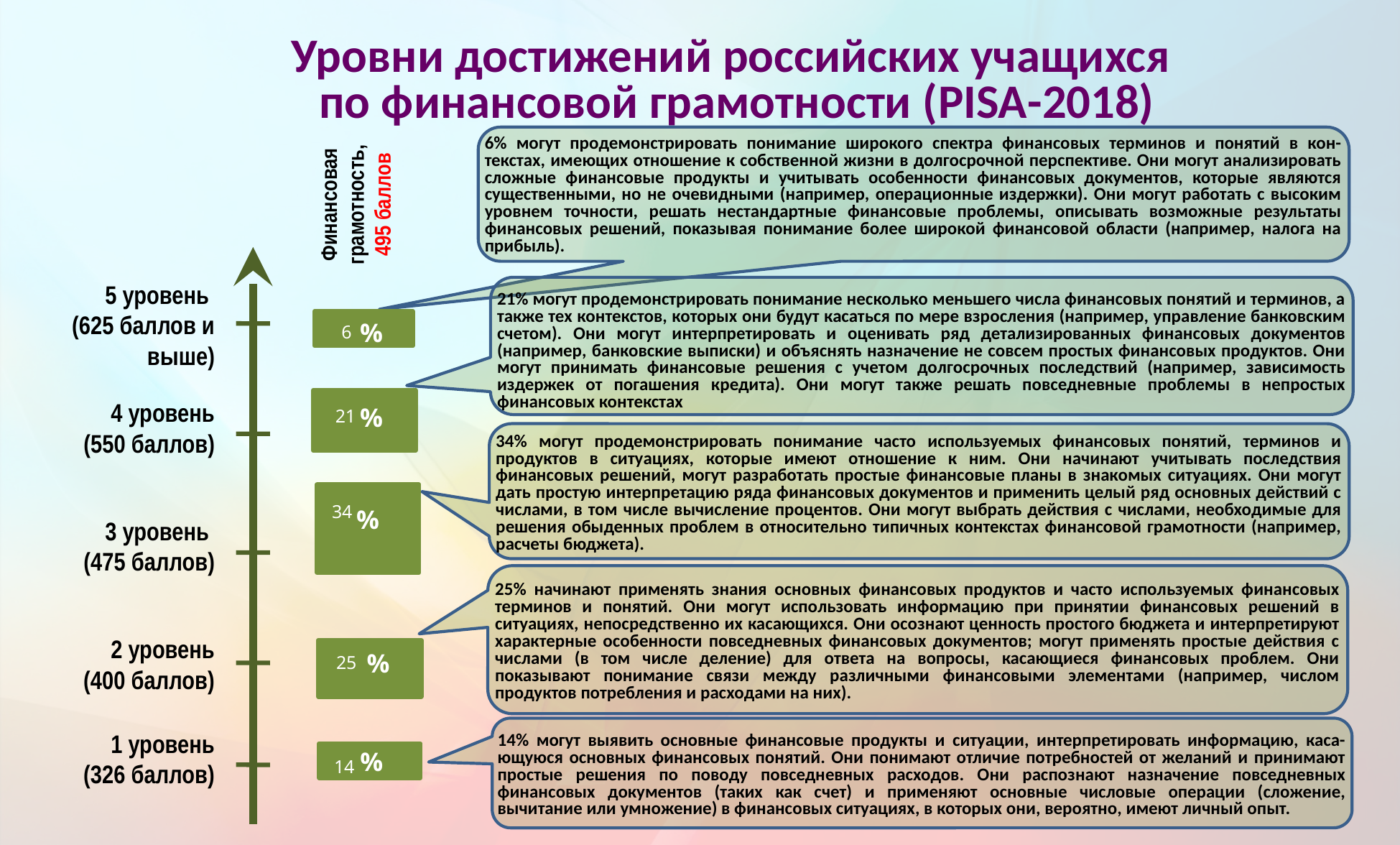
Which level has the largest share of students? 3 уровень (475 баллов) What percentage of students are at level 5 (625 points and above)? 6 % What is the difference in percentage points between level 3 and level 2? 9 Which level has the smallest share of students? 5 уровень (625 баллов и выше) Which has a larger share of students, level 4 or level 1? 4 уровень How many achievement levels are shown on the scale? 5 What percentage of students are at level 1 (326 points)? 14 % What is the combined percentage of students at levels 4 and 5? 27 What score threshold corresponds to level 2? 400 баллов What percentage of Russian students reached level 3 (475 points) in financial literacy? 34 % What percentage of students are at level 4 (550 points)? 21 % What average financial literacy score is shown in red at the top of the scale? 495 баллов